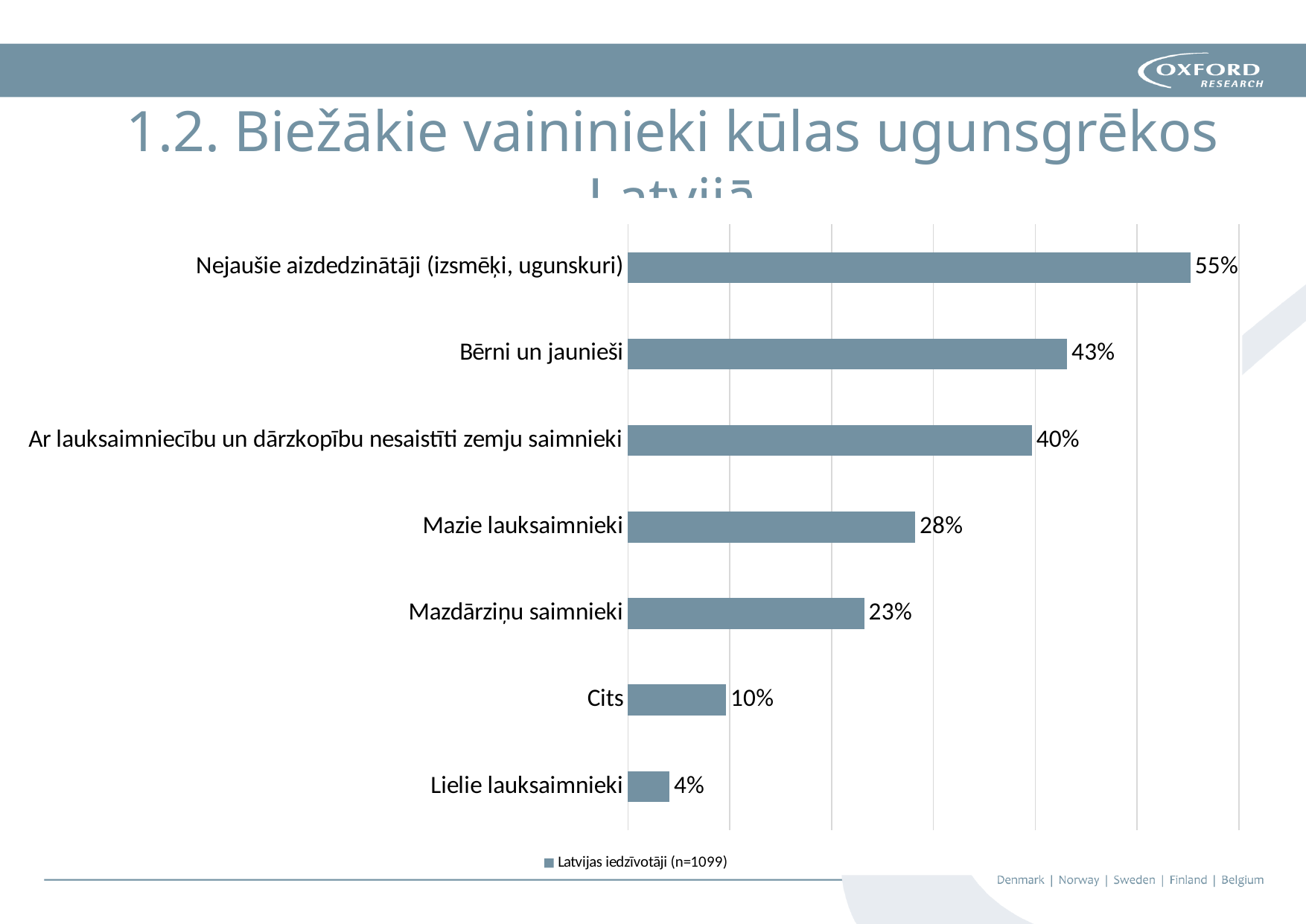
How many categories are shown in the chart? 7 Which category has the highest value? Nejaušie aizdedzinātāji (izsmēķi, ugunskuri) What is the value for Nejaušie aizdedzinātāji (izsmēķi, ugunskuri)? 55% What is the difference between the values for Bērni un jaunieši and Ar lauksaimniecību un dārzkopību nesaistīti zemju saimnieki? 3% What is the difference between the values for Mazie lauksaimnieki and Cits? 18% What kind of chart is shown on the slide? Bar chart Which is larger, the value for Mazie lauksaimnieki or the value for Mazdārziņu saimnieki? Mazie lauksaimnieki What is the value for Bērni un jaunieši? 43% What is the legend entry shown below the chart? Latvijas iedzīvotāji (n=1099) Which category has the lowest value? Lielie lauksaimnieki What is the value for Lielie lauksaimnieki? 4% What is the value for Mazdārziņu saimnieki? 23%